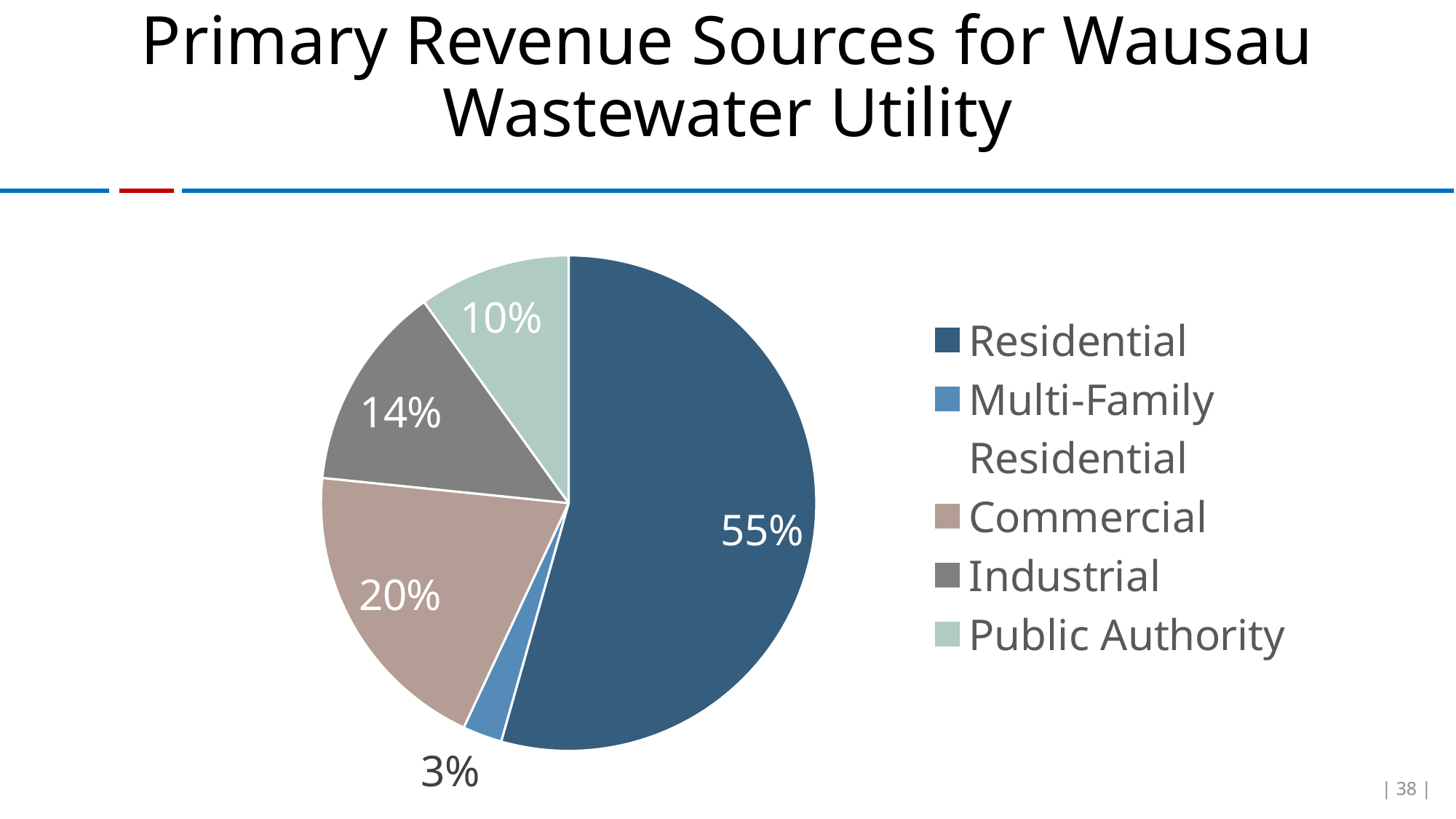
What share of revenue comes from Commercial? 20% What is the difference in percentage points between the Commercial and Industrial shares? 6 What is the title of the chart? Primary Revenue Sources for Wausau Wastewater Utility Which revenue source has the largest share? Residential What share of revenue comes from Multi-Family Residential? 3% Which is larger, the Industrial share or the Public Authority share? Industrial What type of chart is shown on the slide? Pie chart How many revenue sources are shown in the pie chart? 5 What share of revenue comes from Residential? 55% What share of revenue comes from Industrial? 14% What share of revenue comes from Public Authority? 10% Which revenue source has the smallest share? Multi-Family Residential